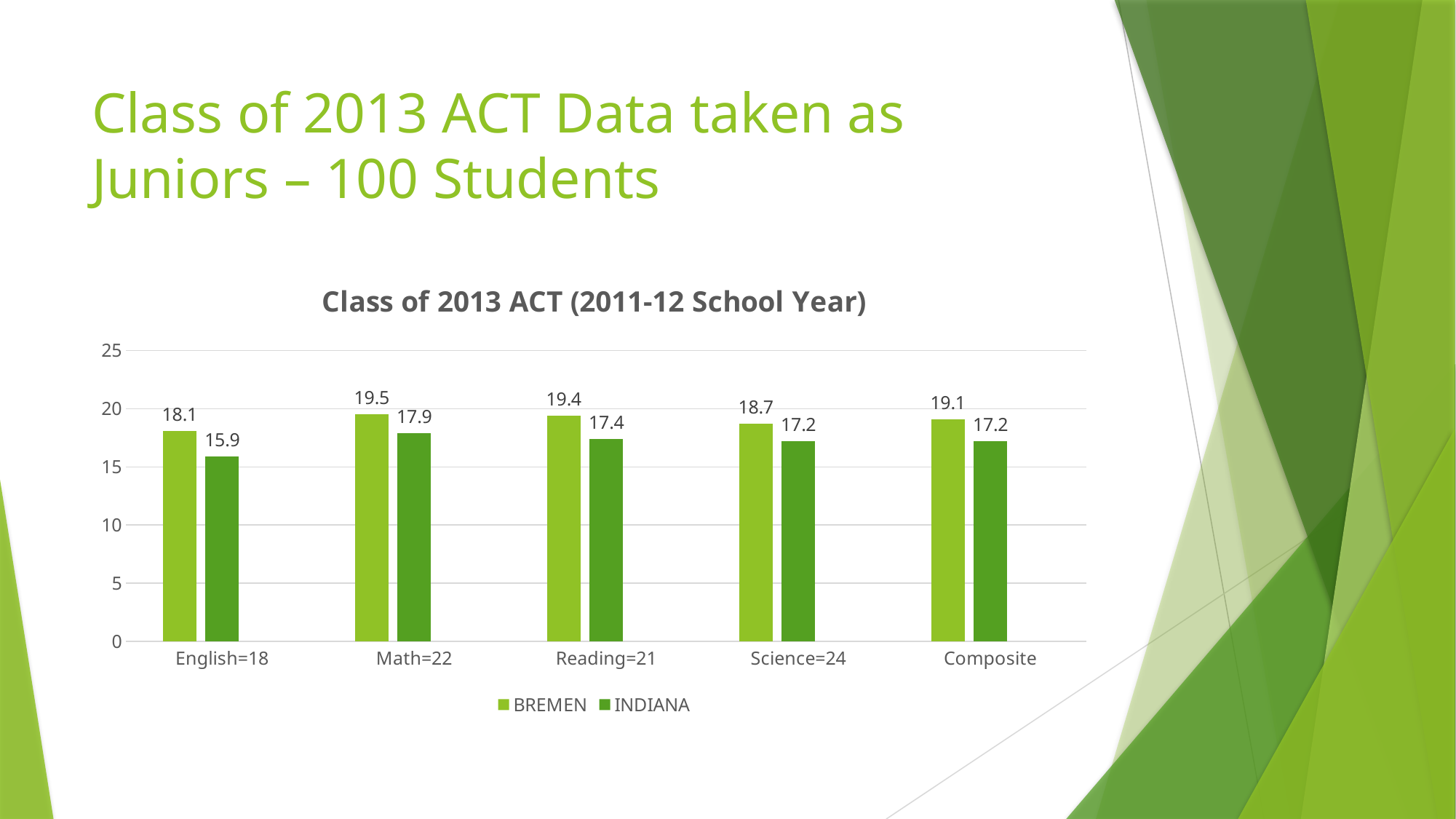
Which category has the lowest INDIANA value? English=18 What kind of chart is shown on the slide? bar chart How many series does the legend list? 2 How many categories are shown on the x axis? 5 Which is larger for Science=24, the BREMEN value or the INDIANA value? BREMEN What is the BREMEN value for Composite? 19.1 What is the title of the chart? Class of 2013 ACT (2011-12 School Year) What is the INDIANA value for English=18? 15.9 Which category has the highest BREMEN value? Math=22 What is the difference between the BREMEN and INDIANA values for English=18? 2.2 Is the INDIANA value for Reading=21 greater or less than 20? less What is the BREMEN value for Math=22? 19.5